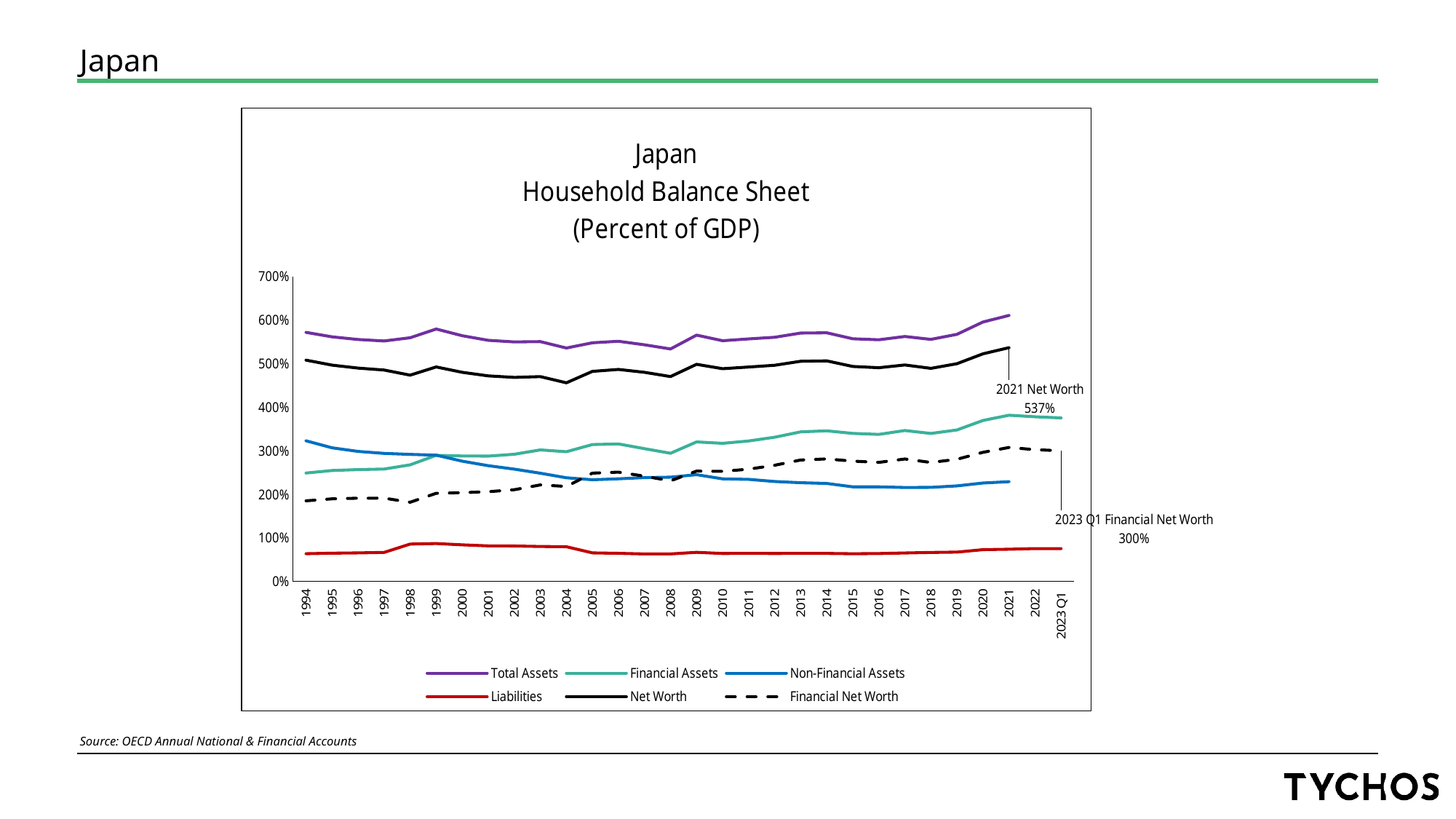
In 1994, which is larger: Financial Assets or Non-Financial Assets? Non-Financial Assets Which series has the highest values across the whole period? Total Assets Which series is drawn with a dashed line? Financial Net Worth Is the value for Total Assets in 2021 greater or less than 600%? greater What kind of chart is shown on the slide? line chart Is the value for Financial Assets in 2021 greater or less than 300%? greater Do Non-Financial Assets rise or fall from 1994 to 2021? fall How many series does the legend list? 6 What is the Net Worth value labelled for 2021? 537% Is the value for Liabilities in 1994 greater or less than 100%? less Which series has the lowest values across the whole period? Liabilities What is the Financial Net Worth value labelled for 2023 Q1? 300%